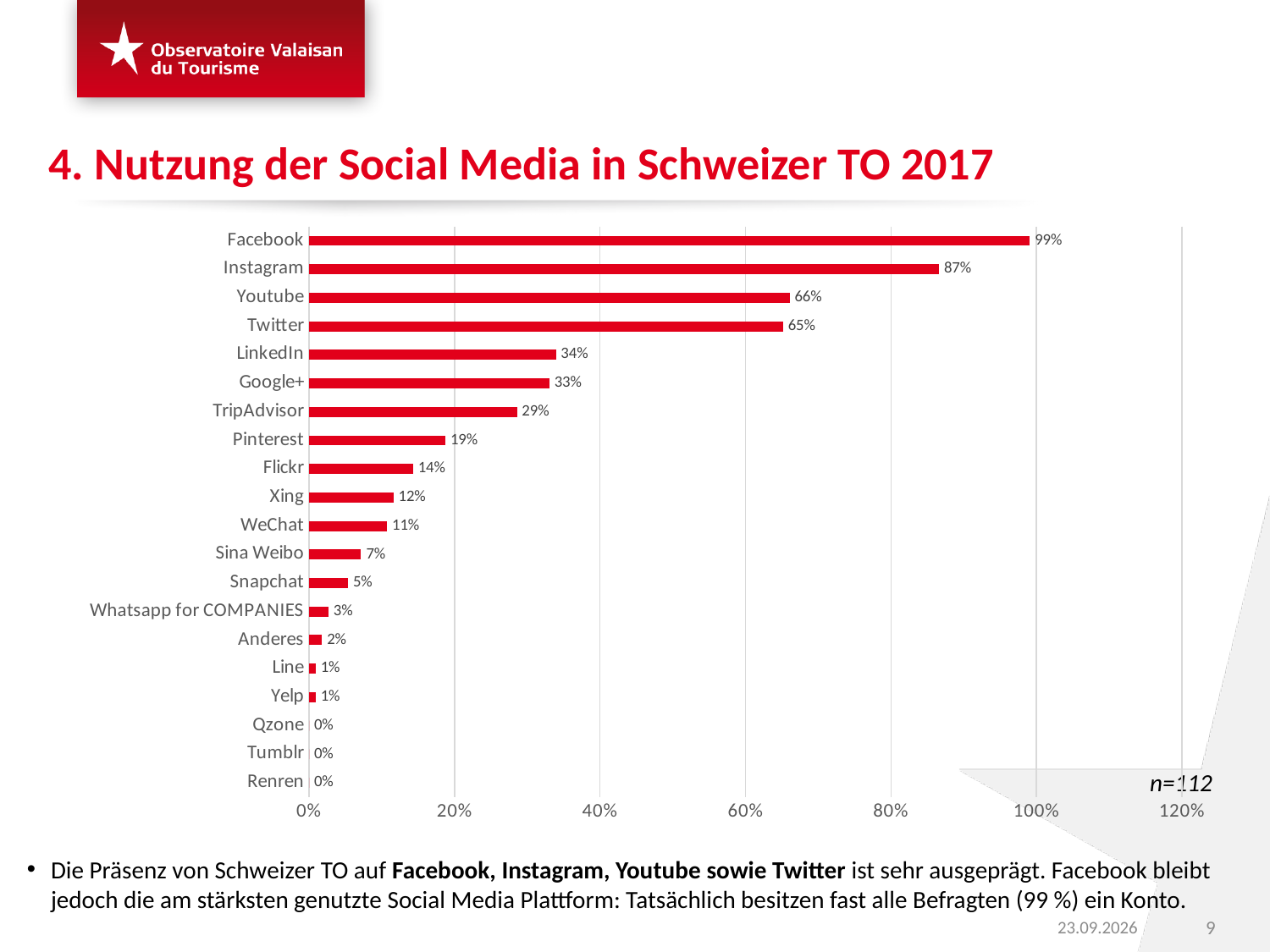
Which category has the highest value? Facebook What is the sample size (n) shown on the chart? n=112 What is the value for Instagram? 87% How many categories are shown on the chart? 20 Which is larger, the value for Xing or the value for Snapchat? Xing What is the difference between the values for LinkedIn and Pinterest? 15% What kind of chart is shown on the slide? bar chart What is the value for WeChat? 11% Which is larger, the value for Youtube or the value for Google+? Youtube Is the value for Twitter greater or less than 60%? greater What is the difference between the values for Facebook and Instagram? 12% What is the value for TripAdvisor? 29%